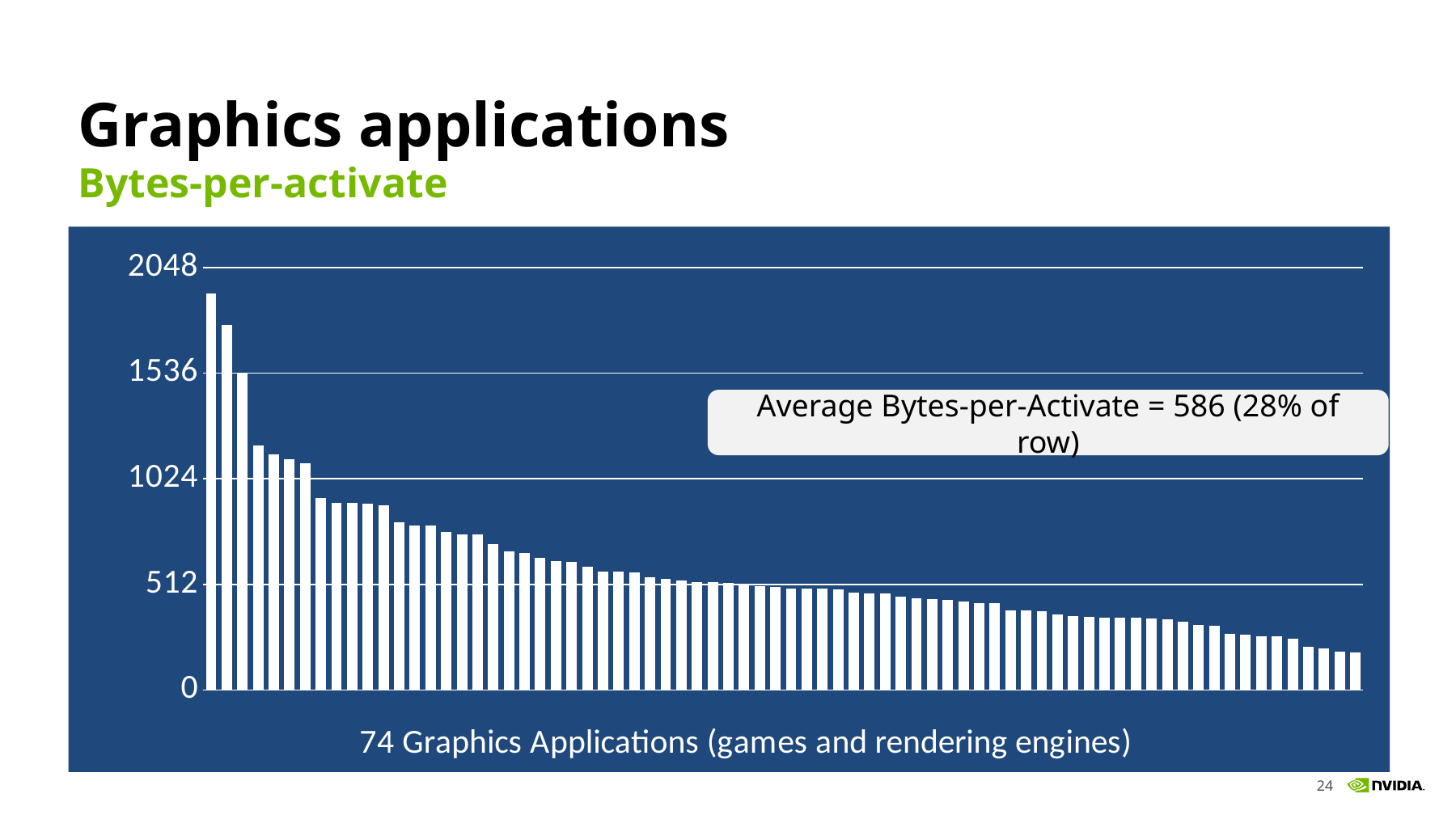
Do the bar values rise or fall from left to right along the x axis? Fall Is the value of the second bar from the left greater or less than 1536? greater Is the value of the shortest (rightmost) bar greater or less than 512? less Which bar is the highest: the leftmost bar or the rightmost bar? The leftmost bar What is the average Bytes-per-Activate stated on the chart? 586 According to the annotation, what percentage of a row does the average Bytes-per-Activate of 586 represent? 28% What is the highest value shown on the y axis? 2048 What kind of chart is shown on the slide? Bar chart How many graphics applications are plotted in the chart? 74 Is the value of the tallest (leftmost) bar greater or less than 1536? greater What is the x-axis label of the chart? 74 Graphics Applications (games and rendering engines)